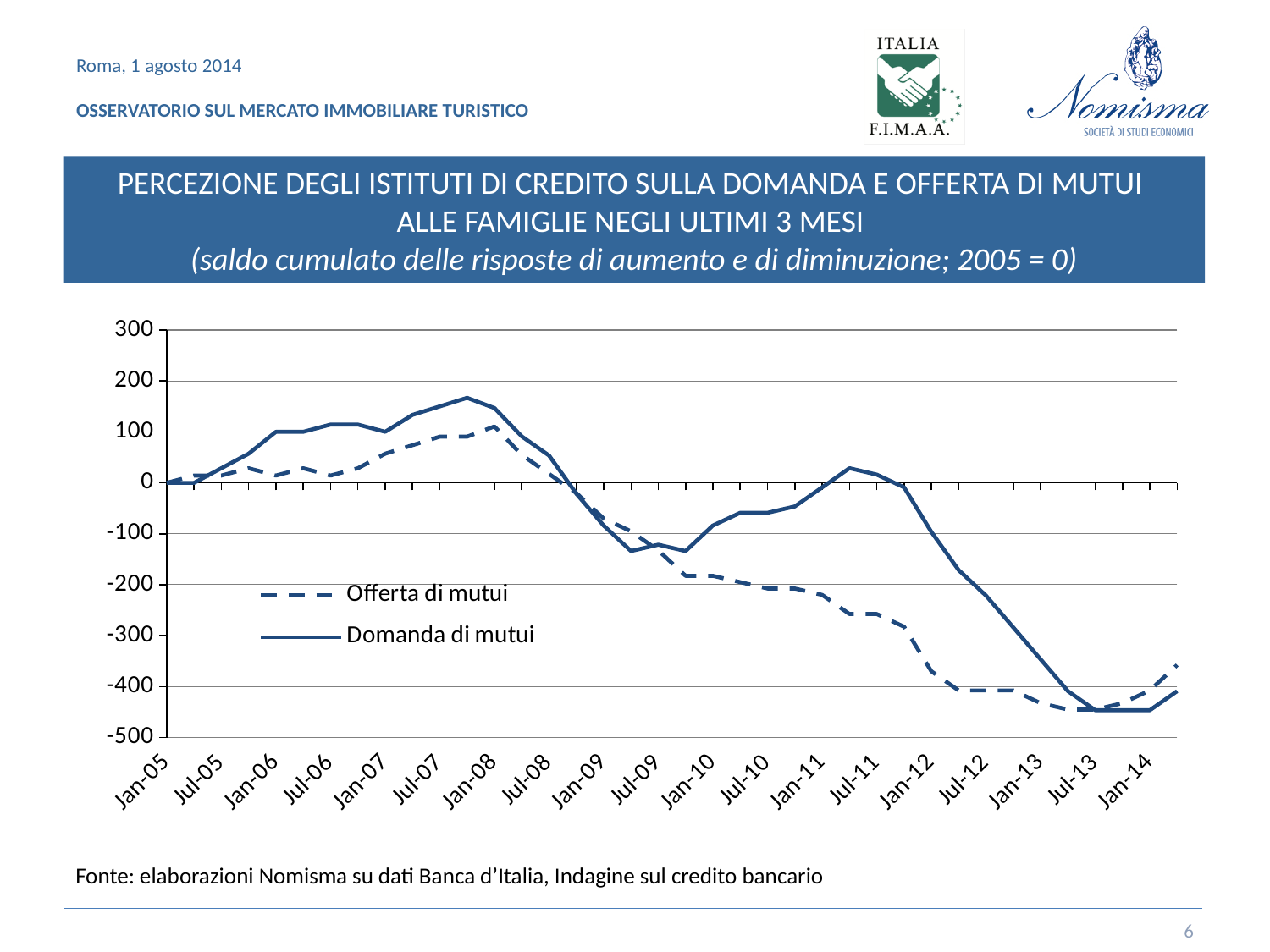
Does Domanda di mutui rise or fall between Jan-08 and Jan-09? Fall Which series is drawn with a dashed line? Offerta di mutui Is the value of Offerta di mutui at Jul-13 greater or less than -400? less How many series does the legend list? 2 At Jul-11, which series has the higher value, Offerta di mutui or Domanda di mutui? Domanda di mutui Is the value of Offerta di mutui at Jan-10 greater or less than -100? less At Jan-08, which series has the higher value, Offerta di mutui or Domanda di mutui? Domanda di mutui What kind of chart is shown on the slide? Line chart Is the value of Domanda di mutui at Jul-11 greater or less than 0? greater How many date labels are shown along the x axis? 19